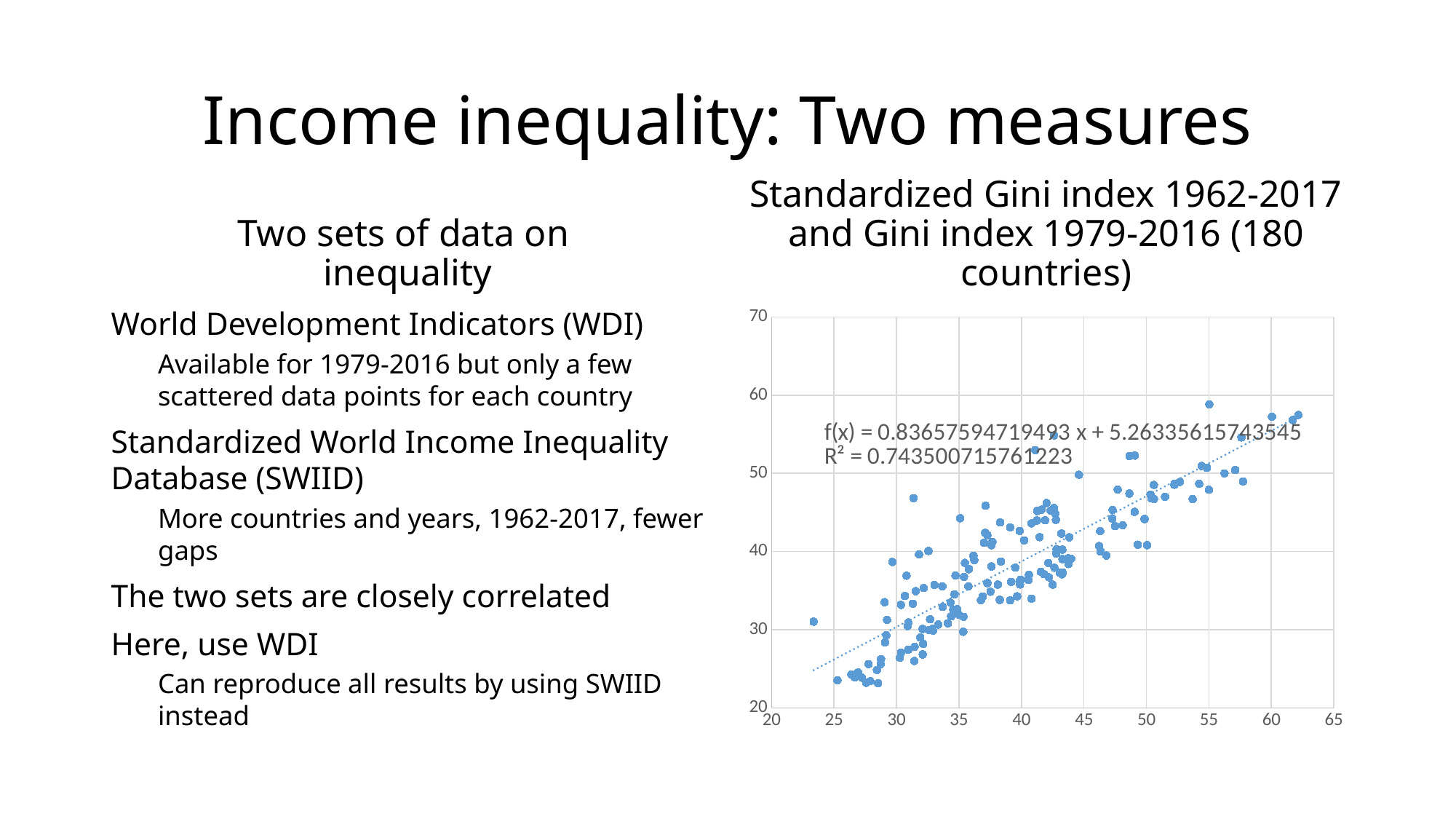
Is the y value of the lowest plotted point greater or less than 25? less What is the R² value printed on the chart? R² = 0.743500715761223 Do the plotted values tend to rise or fall as the x-axis value increases? rise Is the y value of the leftmost plotted point (near x = 23) greater or less than 30? greater What is the title of the chart? Standardized Gini index 1962-2017 and Gini index 1979-2016 (180 countries) According to the chart title, how many countries are included in the data? 180 Is the y value of the highest plotted point greater or less than 55? greater What kind of chart is shown on the slide? scatter chart